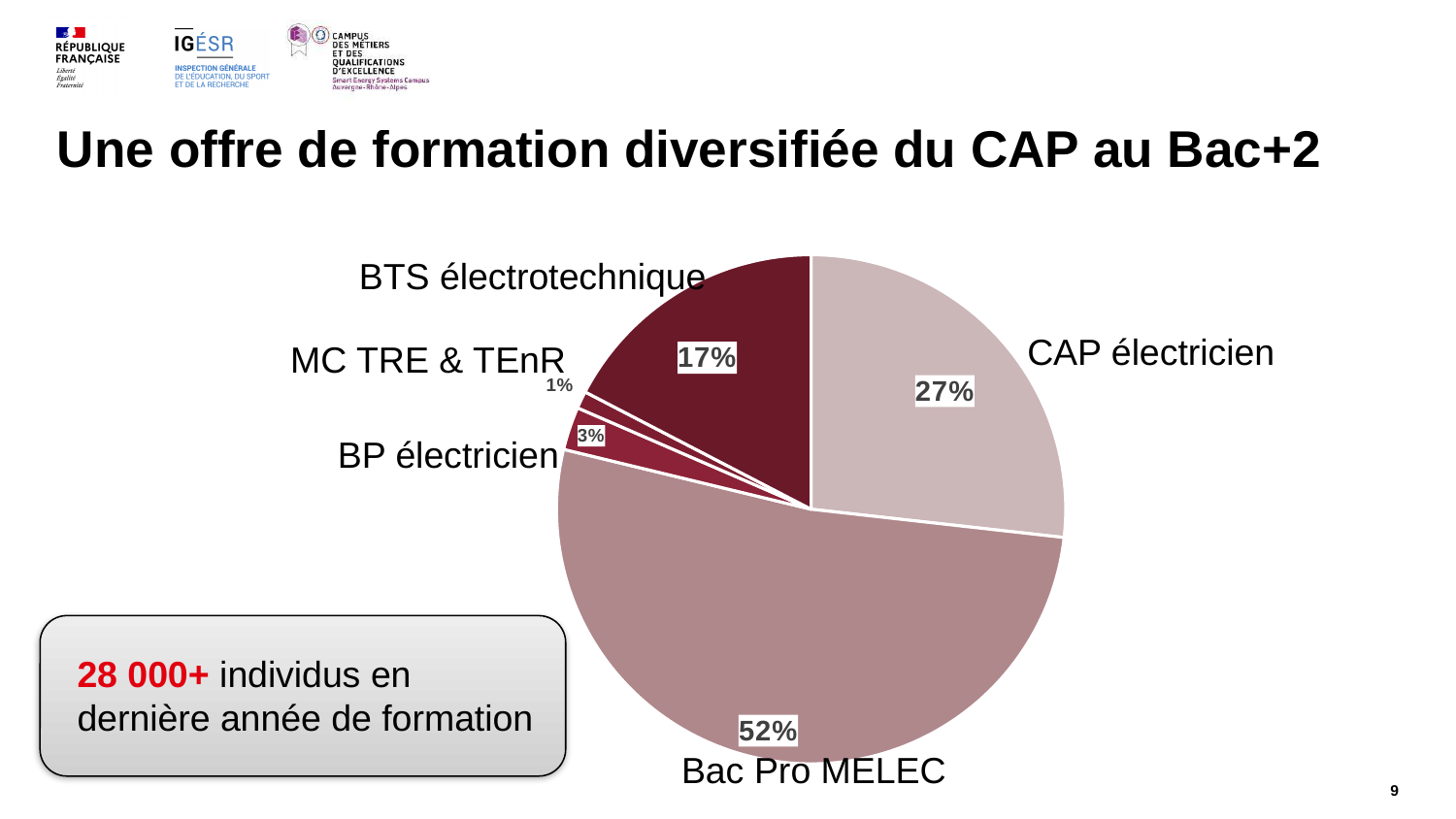
What is the difference in percentage points between BTS électrotechnique and BP électricien? 14 What share of the pie does Bac Pro MELEC represent? 52% What is the value shown for CAP électricien? 27% What type of chart is shown on the slide? pie chart What is the value shown for BP électricien? 3% What is the difference in percentage points between Bac Pro MELEC and CAP électricien? 25 What is the title of the slide containing the pie chart? Une offre de formation diversifiée du CAP au Bac+2 Which is larger, the share for CAP électricien or the share for BTS électrotechnique? CAP électricien What is the value shown for BTS électrotechnique? 17% What is the value shown for MC TRE & TEnR? 1% Which category has the largest share of the pie? Bac Pro MELEC Which category has the smallest share of the pie? MC TRE & TEnR